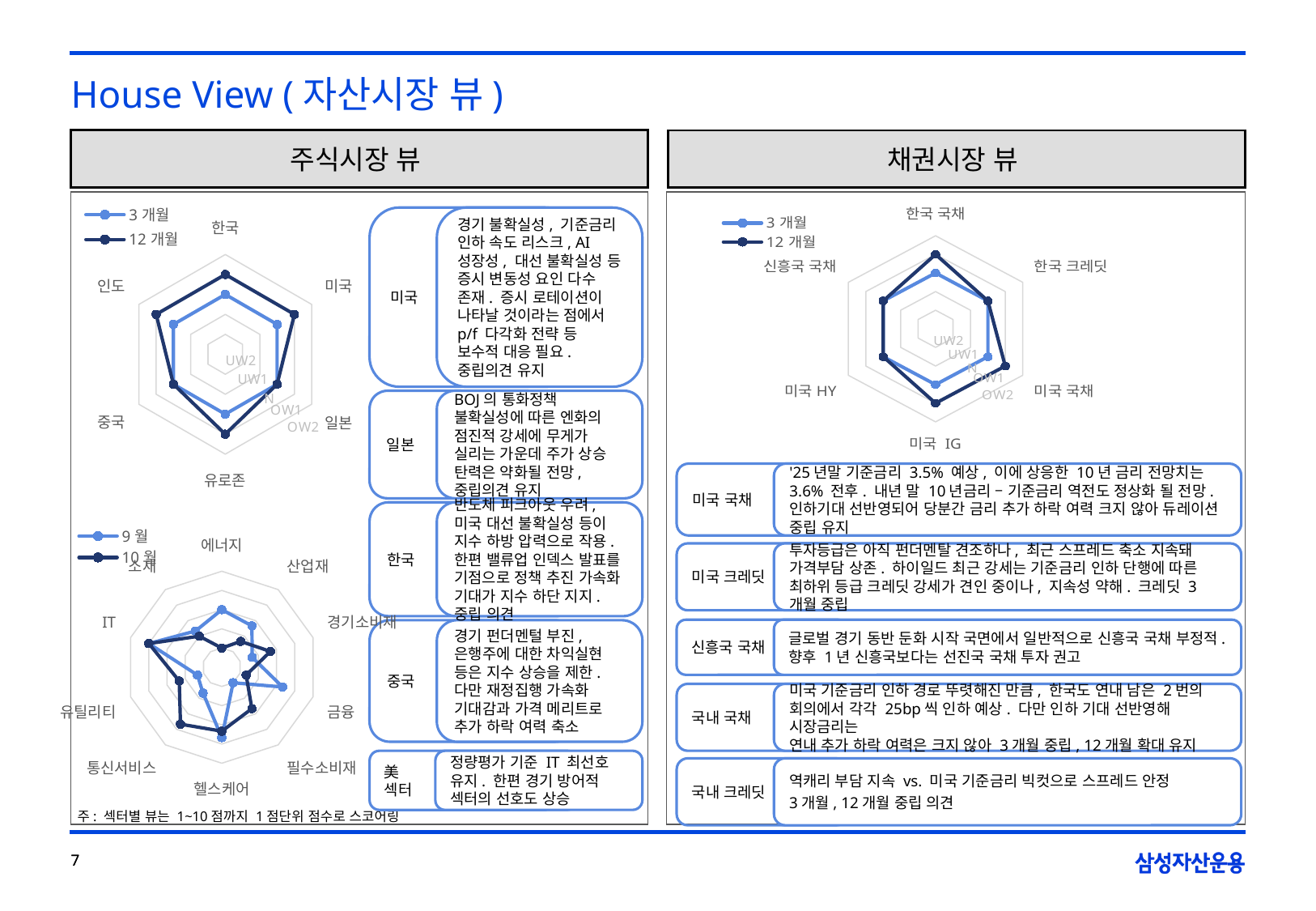
What kind of chart is the chart in the 주식시장 뷰 panel with the categories 한국, 미국, 일본, 유로존, 중국 and 인도? Radar chart In the top radar chart of the 주식시장 뷰 panel, which series has the higher value for 한국, 3 개월 or 12 개월? 12 개월 What are the two legend entries of the top radar chart in the 주식시장 뷰 panel? 3 개월, 12 개월 How many categories does the radar chart in the 주식시장 뷰 panel with 한국, 미국, 일본, 유로존, 중국 and 인도 have? 6 What are the legend entries of the sector radar chart in the 주식시장 뷰 panel? 9 월, 10 월 How many series does the legend of the radar chart in the 채권시장 뷰 panel list? 2 How many series does the legend of the top radar chart in the 주식시장 뷰 panel list? 2 How many categories does the radar chart in the 채권시장 뷰 panel have? 6 How many categories does the sector radar chart in the 주식시장 뷰 panel (에너지, 산업재, 경기소비재, ...) have? 10 How many series does the legend of the sector radar chart in the 주식시장 뷰 panel list? 2 What kind of chart is shown in the 채권시장 뷰 panel? Radar chart In the radar chart of the 채권시장 뷰 panel, which series has the higher value for 미국 IG, 3 개월 or 12 개월? 12 개월